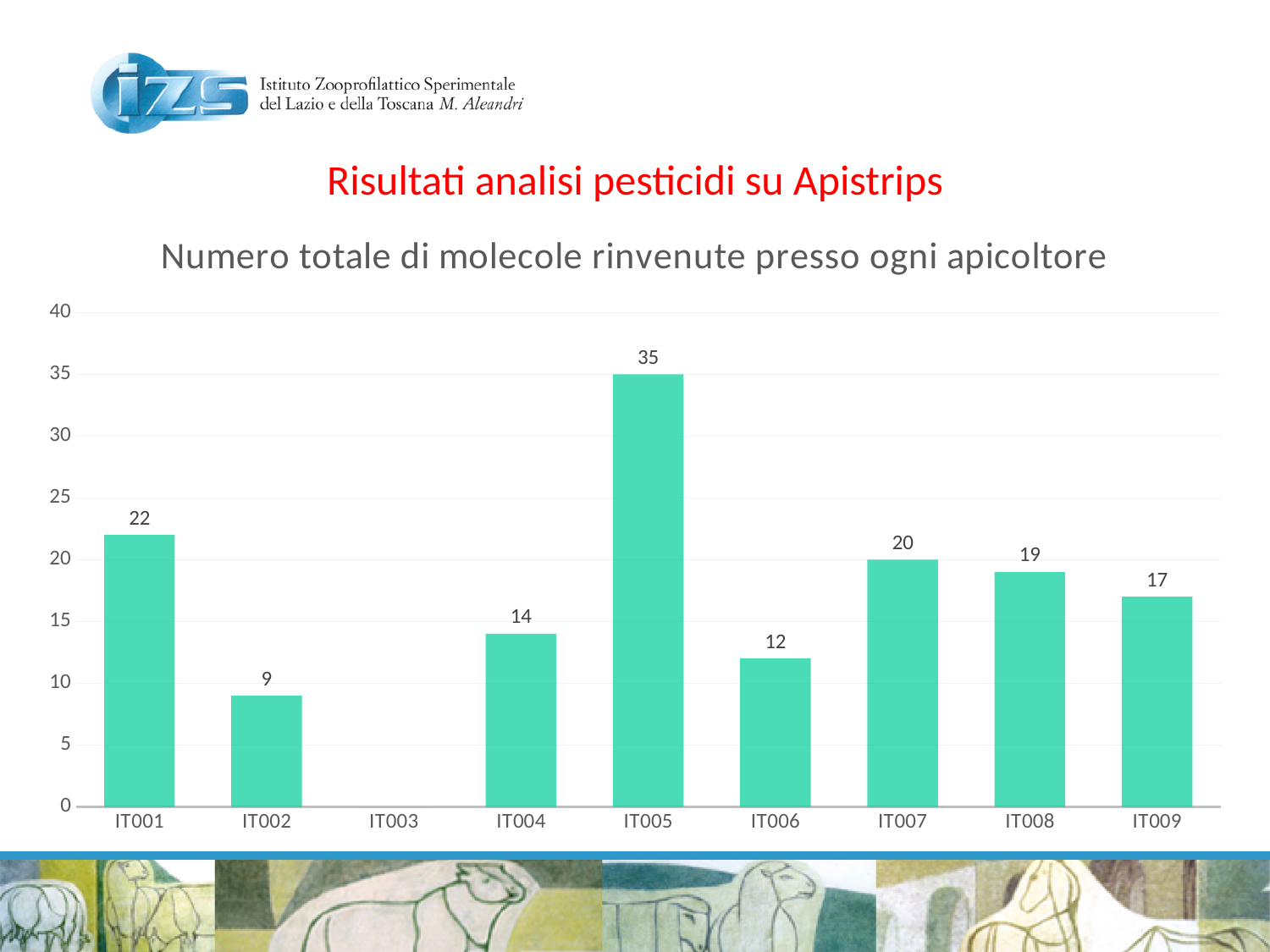
What is the value for IT008? 19 What is the title of the chart? Numero totale di molecole rinvenute presso ogni apicoltore Which category has no bar displayed? IT003 Which is larger, the value for IT004 or the value for IT009? IT009 What kind of chart is shown on the slide? bar chart How many categories are shown on the x axis? 9 What is the value for IT002? 9 What is the difference between the values for IT005 and IT001? 13 Is the value for IT001 greater or less than 20? greater Which category has the highest value? IT005 What is the difference between the values for IT007 and IT006? 8 What is the value for IT005? 35